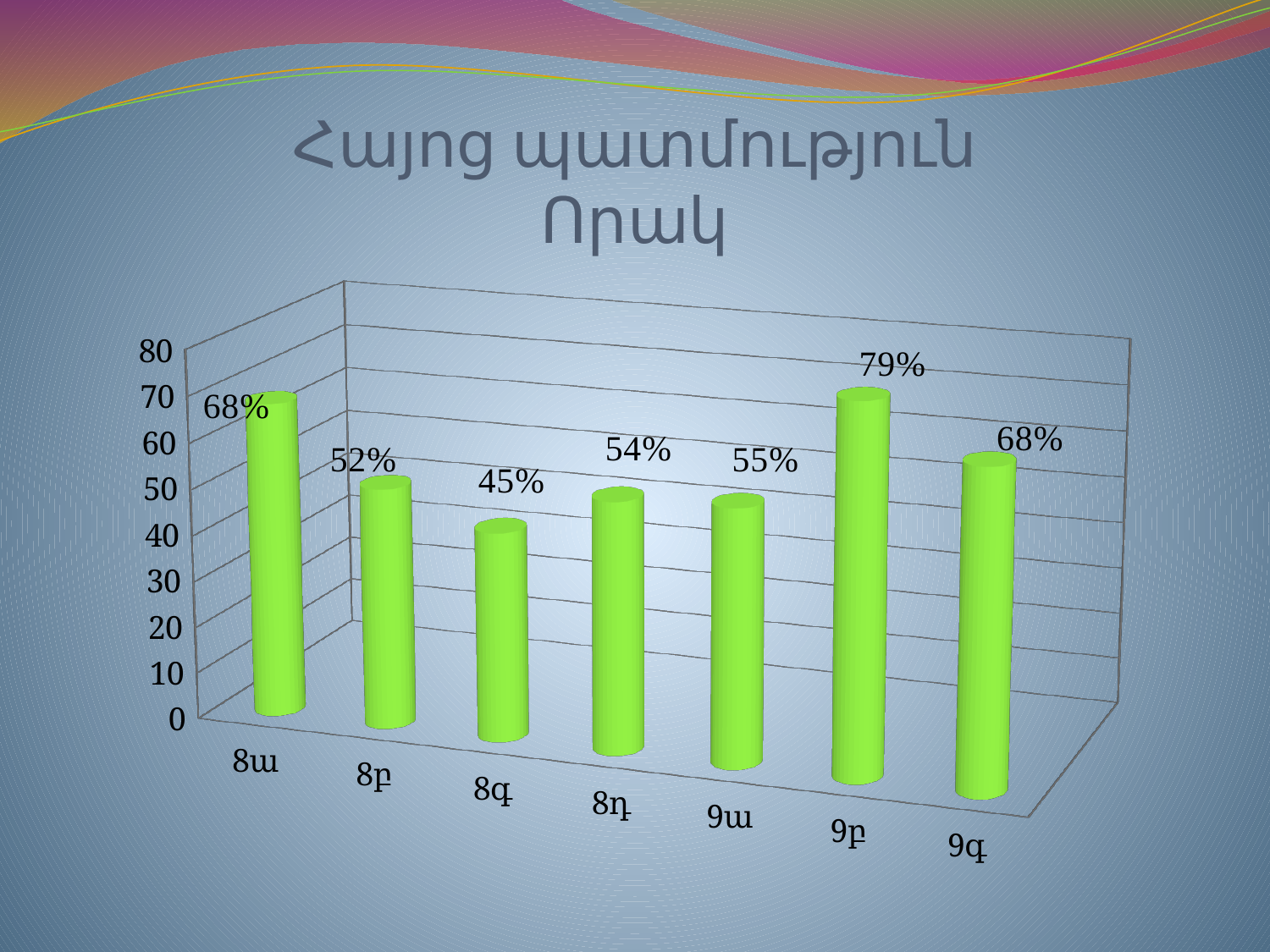
What is the difference between the values for 9բ and 8գ? 34% Is the value for 9գ greater or less than 60? greater Which category has the highest value? 9բ What is the value for 9ա? 55% What is the value for 8ա? 68% Which category has the lowest value? 8գ How many categories are shown on the x axis? 7 Which is larger, the value for 8բ or the value for 8դ? 8դ What is the value for 8գ? 45% What kind of chart is shown on the slide? bar chart What is the title of the slide? Հայոց պատմություն Որակ What is the value for 9բ? 79%